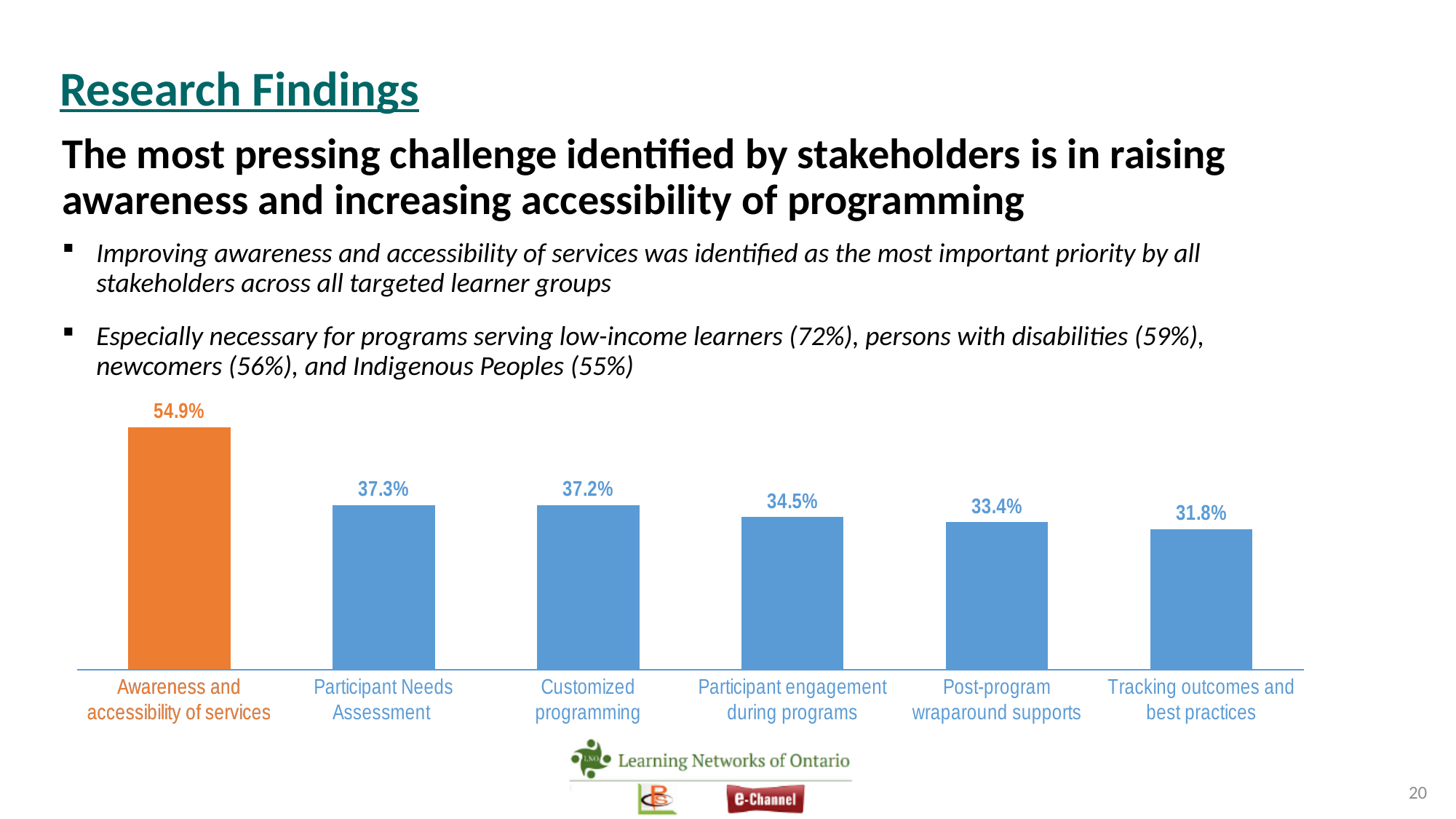
What is the difference between Awareness and accessibility of services and Customized programming? 17.7% What is the difference between Participant engagement during programs and Tracking outcomes and best practices? 2.7% Which category has the lowest value? Tracking outcomes and best practices What is the value for Participant Needs Assessment? 37.3% How many categories are shown in the chart? 6 What is the value for Post-program wraparound supports? 33.4% What is the value for Tracking outcomes and best practices? 31.8% Which bar is coloured orange rather than blue? Awareness and accessibility of services What kind of chart is shown on the slide? Bar chart Which category has the highest value? Awareness and accessibility of services What is the value for Awareness and accessibility of services? 54.9% Which is larger, Participant engagement during programs or Post-program wraparound supports? Participant engagement during programs